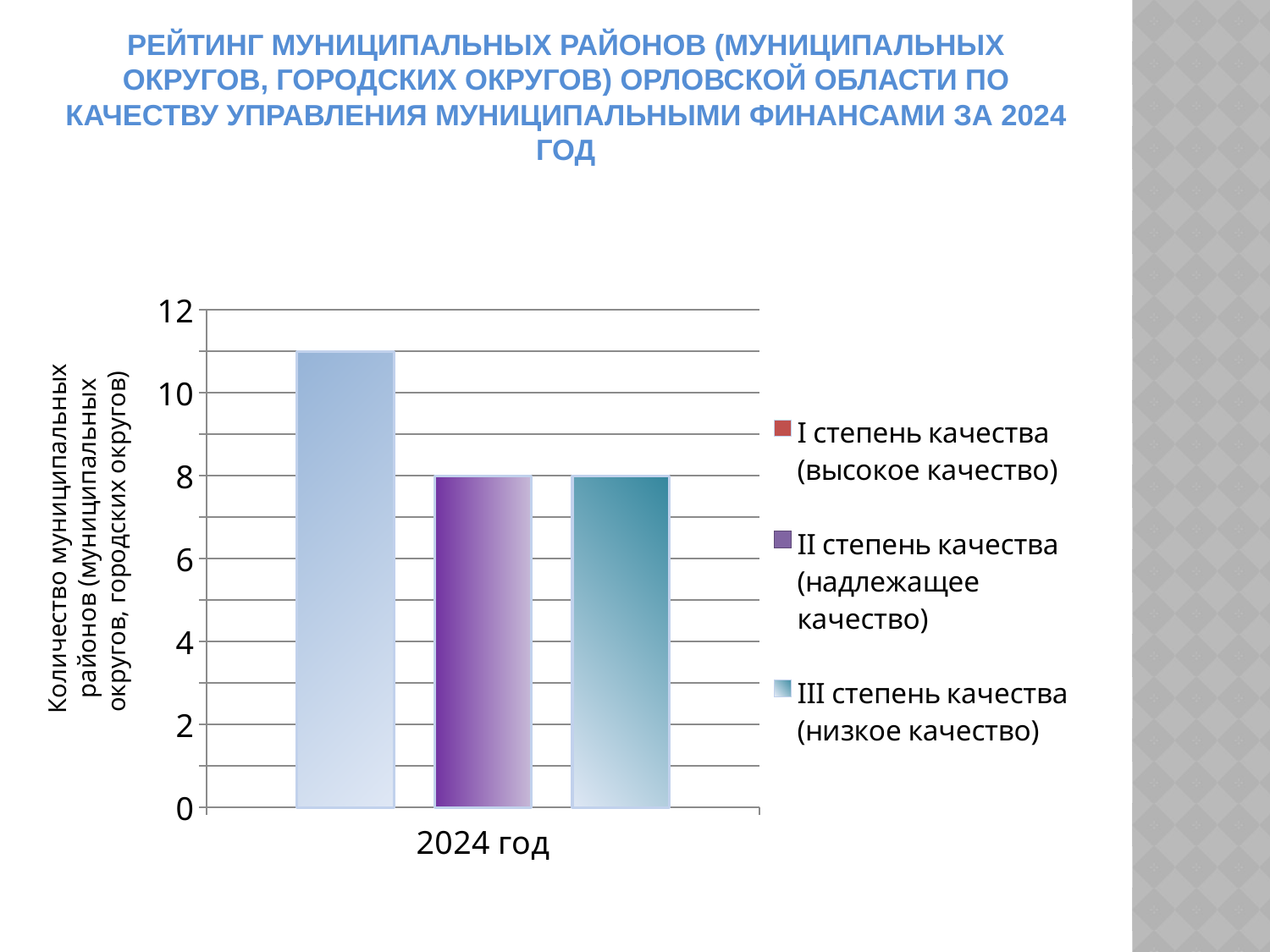
What is the value for III степень качества (низкое качество) in 2024 год? 8 What is the highest tick value shown on the y axis? 12 What is the category label shown on the x axis? 2024 год Which is larger: the bar for I степень качества or the bar for II степень качества? I степень качества What is the value for II степень качества (надлежащее качество) in 2024 год? 8 Which series has the highest bar? I степень качества (высокое качество) How many categories are shown on the x axis? 1 Is the value for I степень качества (высокое качество) greater or less than 10? greater How many series does the legend list? 3 What kind of chart is shown on the slide? bar chart Is the value for I степень качества (высокое качество) greater or less than 12? less What is the difference between the values for II степень качества and III степень качества? 0